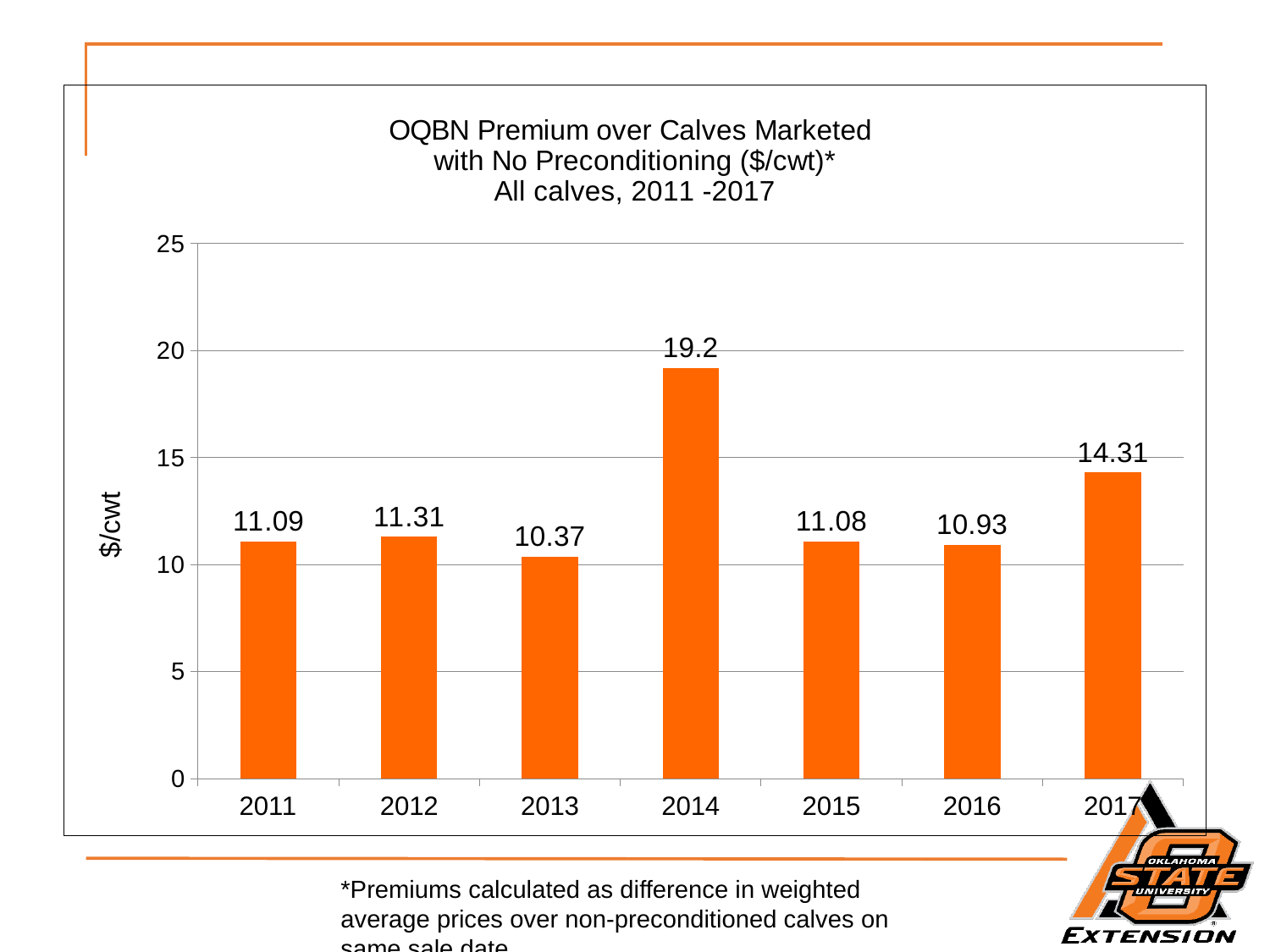
What is the label on the vertical axis? $/cwt What is the OQBN premium for 2017? 14.31 Is the value for 2014 greater or less than 15? greater What is the OQBN premium for 2014? 19.2 Which year has the lowest OQBN premium? 2013 Which year has a larger premium, 2012 or 2016? 2012 What is the difference between the 2012 premium and the 2013 premium? 0.94 What is the difference between the 2014 premium and the 2017 premium? 4.89 How many years are shown on the x axis? 7 Which year has the highest OQBN premium? 2014 What is the OQBN premium for 2013? 10.37 What kind of chart is shown on the slide? bar chart